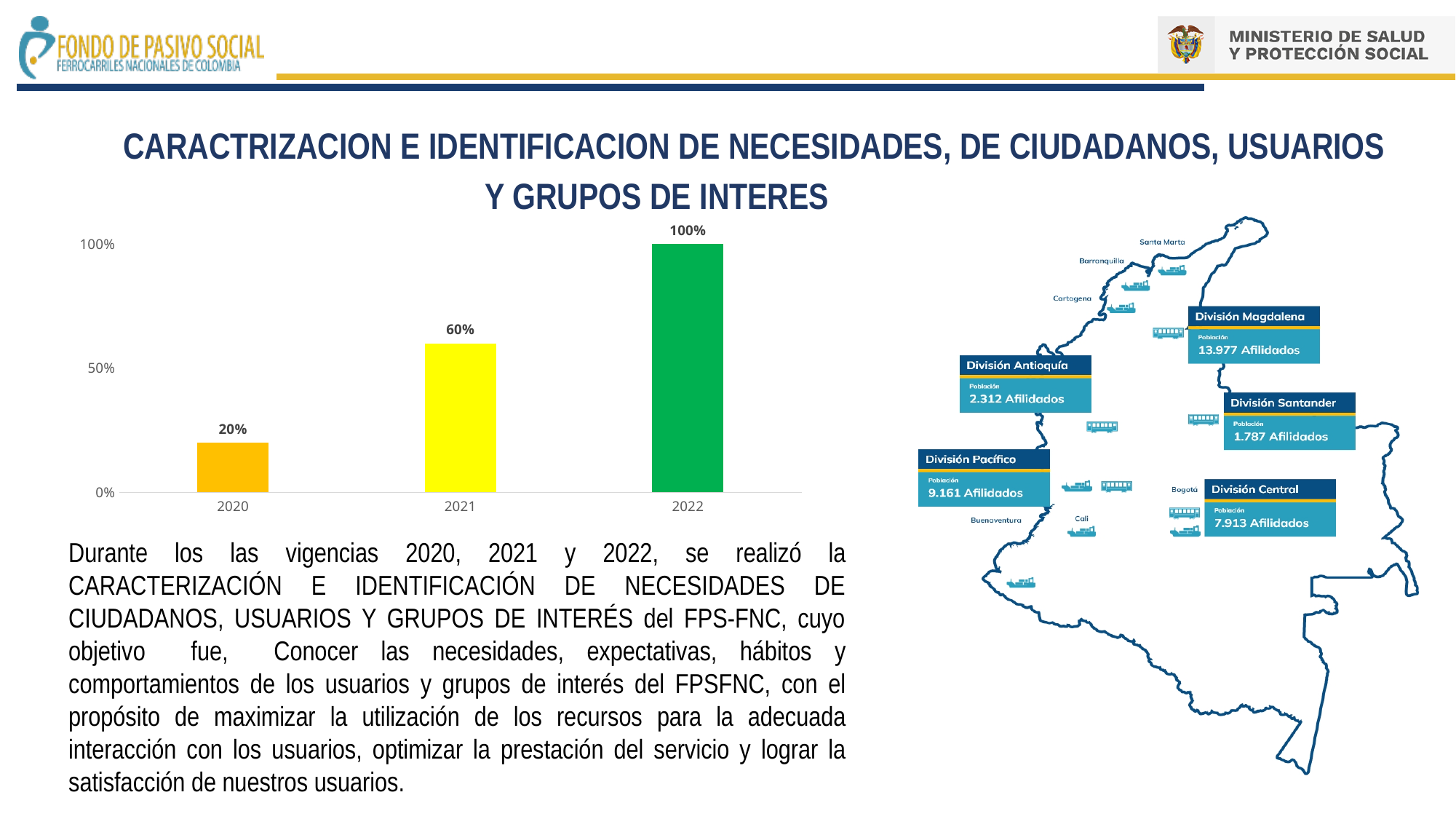
Which year has the highest value in the bar chart? 2022 Is the value for 2021 in the bar chart greater or less than 50%? greater Which year has the lowest value in the bar chart? 2020 Which is larger in the bar chart, the value for 2020 or the value for 2021? 2021 What is the value shown for 2022 in the bar chart? 100% How many years are shown on the x axis of the bar chart? 3 What is the value shown for 2020 in the bar chart? 20% Do the values in the bar chart rise or fall from 2020 to 2022? rise What is the value shown for 2021 in the bar chart? 60% What is the difference between the values for 2022 and 2021 in the bar chart? 40% What kind of chart is shown on the left of the slide? bar chart What is the difference between the values for 2021 and 2020 in the bar chart? 40%